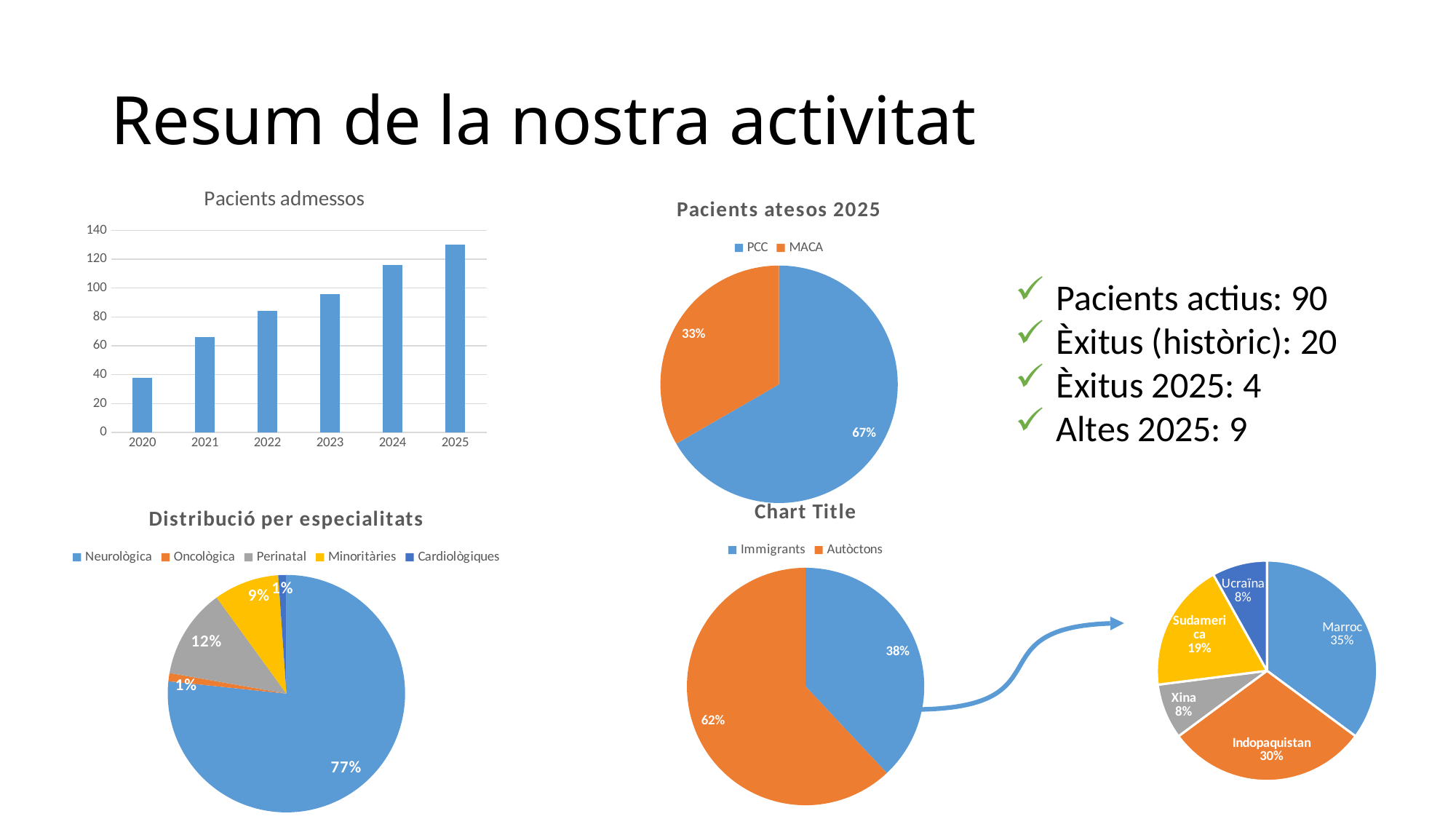
In the 'Pacients admessos' chart, is the value for 2024 greater or less than 100? greater In the 'Pacients admessos' chart, which year has the lowest value? 2020 In the 'Pacients atesos 2025' pie chart, what is the difference between the PCC and MACA shares? 34% In the 'Pacients admessos' chart, which year has the highest value? 2025 In the 'Distribució per especialitats' pie chart, how many categories does the legend list? 5 In the 'Pacients admessos' chart, what kind of chart is shown? bar chart In the 'Pacients admessos' chart, do the values rise or fall from 2020 to 2025? rise In the 'Pacients atesos 2025' pie chart, what share does PCC have? 67% In the pie chart titled 'Chart Title', which is larger, Immigrants or Autòctons? Autòctons In the 'Pacients admessos' chart, how many years are shown on the x axis? 6 In the 'Distribució per especialitats' pie chart, what share does Perinatal have? 12%